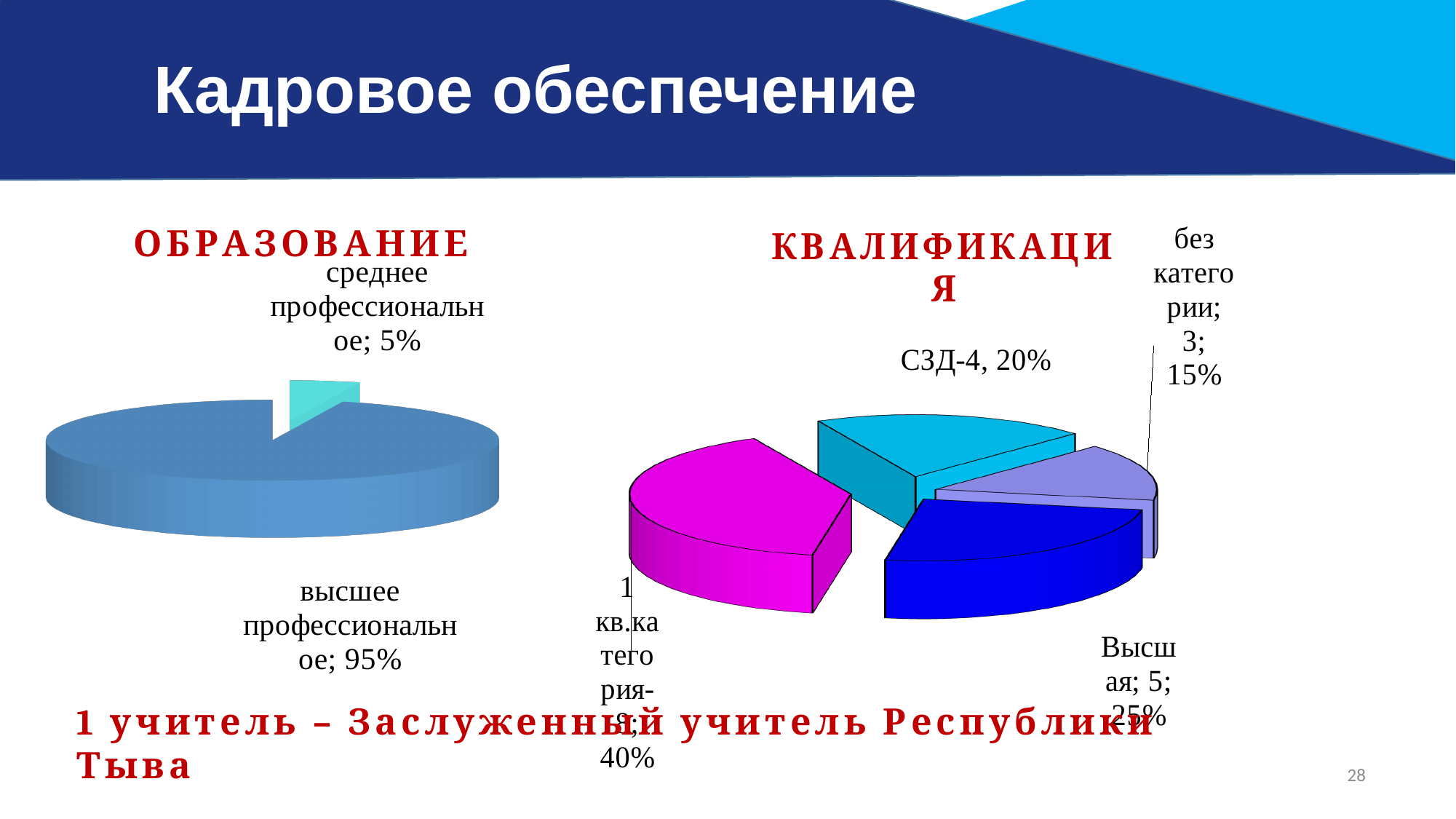
In the ОБРАЗОВАНИЕ chart, which category has the largest slice? высшее профессиональное In the ОБРАЗОВАНИЕ chart, what share is labelled for высшее профессиональное? 95% How many slices does the ОБРАЗОВАНИЕ chart have? 2 What kind of chart is the ОБРАЗОВАНИЕ chart on the left? pie chart In the КВАЛИФИКАЦИЯ chart, how many teachers are labelled as без категории? 3 In the ОБРАЗОВАНИЕ chart, what share is labelled for среднее профессиональное? 5% In the ОБРАЗОВАНИЕ chart, what is the difference in percentage points between высшее профессиональное and среднее профессиональное? 90 In the КВАЛИФИКАЦИЯ chart, which is larger: the share for Высшая or the share for СЗД? Высшая In the КВАЛИФИКАЦИЯ chart, what percentage is labelled for СЗД? 20% What kind of chart is the КВАЛИФИКАЦИЯ chart on the right? pie chart In the КВАЛИФИКАЦИЯ chart, what percentage is labelled for Высшая? 25% In the КВАЛИФИКАЦИЯ chart, which category has the smallest share? без категории